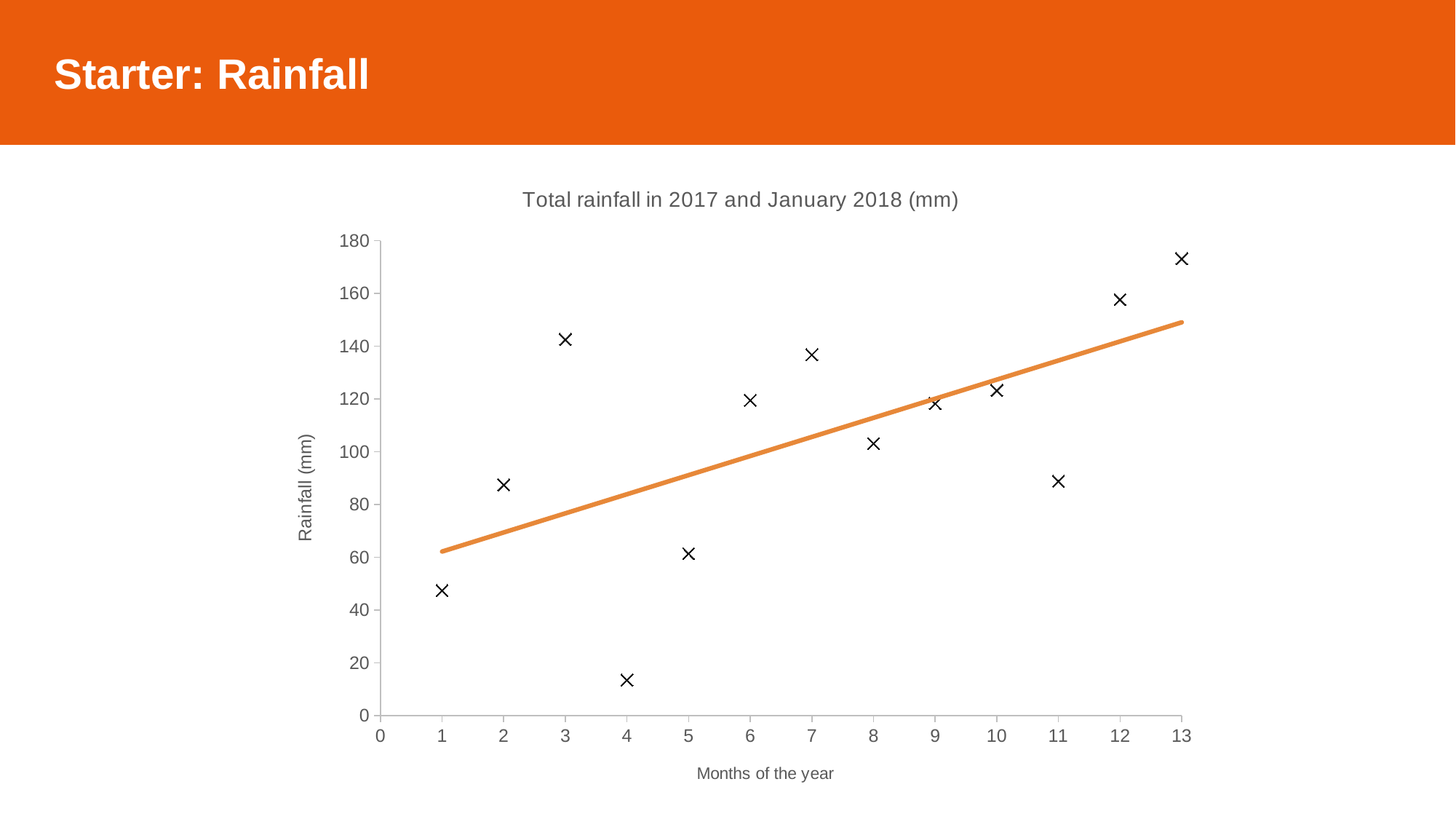
Is the rainfall value for month 4 greater or less than 20? less What is the title of the chart? Total rainfall in 2017 and January 2018 (mm) Which has the larger rainfall value, month 11 or month 12? Month 12 Is the rainfall value for month 13 greater or less than 160? greater Is the rainfall value for month 1 greater or less than 60? less How many data points are plotted on the chart? 13 Does the orange trend line rise or fall as the months increase? Rises Which month has the lowest rainfall value? 4 Which month has the highest rainfall value? 13 Which has the larger rainfall value, month 7 or month 8? Month 7 What kind of chart is shown on the slide? Scatter chart